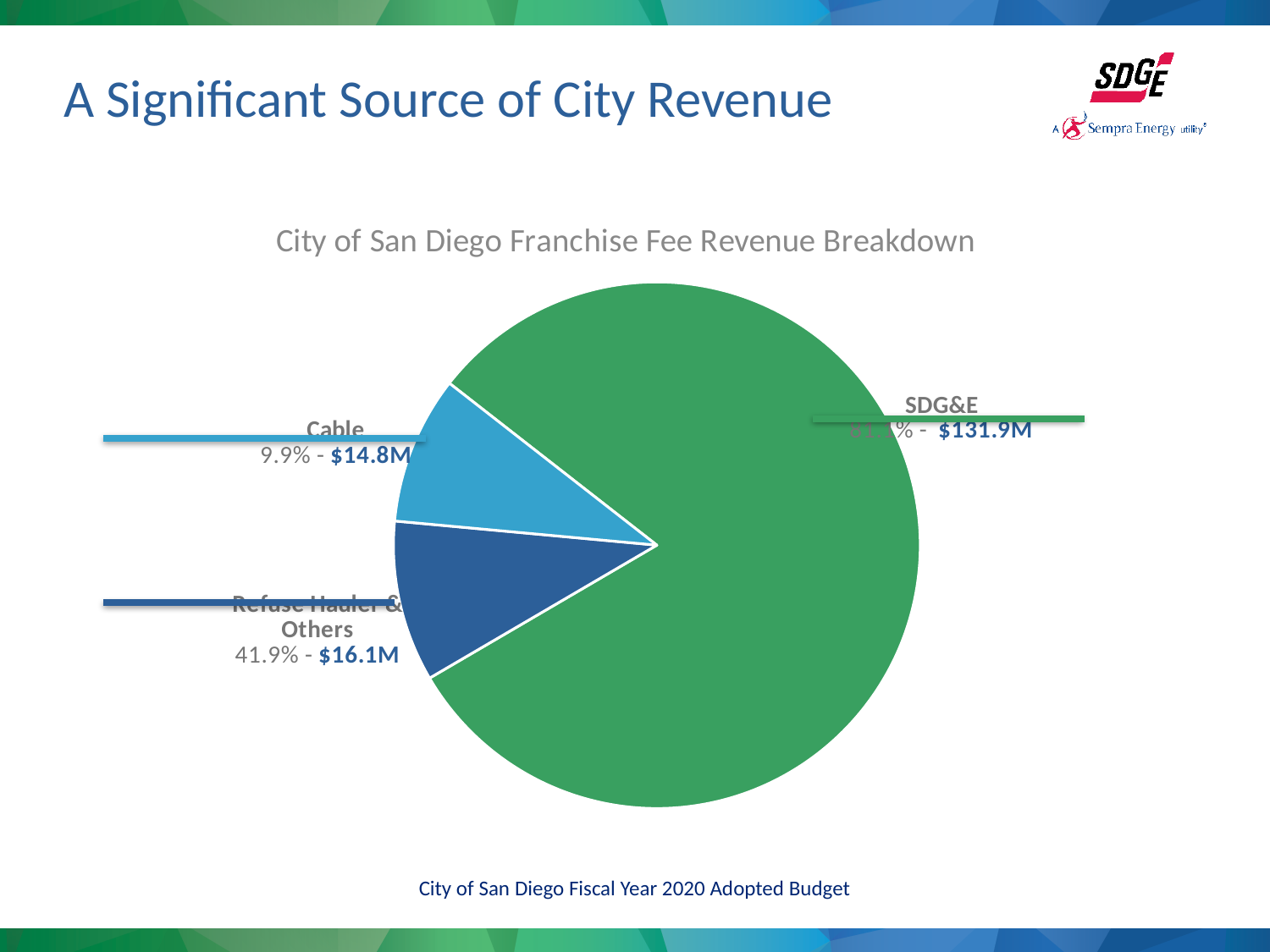
What kind of chart is shown on the slide? Pie chart Which category has the smallest slice of the pie? Cable What is the difference between the SDG&E value and the Cable value? $117.1M What is the difference between the Refuse Hauler & Others value and the Cable value? $1.3M What is the title of the chart? City of San Diego Franchise Fee Revenue Breakdown Which is larger, the value for Refuse Hauler & Others or the value for Cable? Refuse Hauler & Others What is the franchise fee revenue value shown for Refuse Hauler & Others? $16.1M How many slices does the pie chart have? 3 What is the franchise fee revenue value shown for Cable? $14.8M What source is cited below the chart? City of San Diego Fiscal Year 2020 Adopted Budget What is the franchise fee revenue value shown for SDG&E? $131.9M Which category has the largest slice of the pie? SDG&E